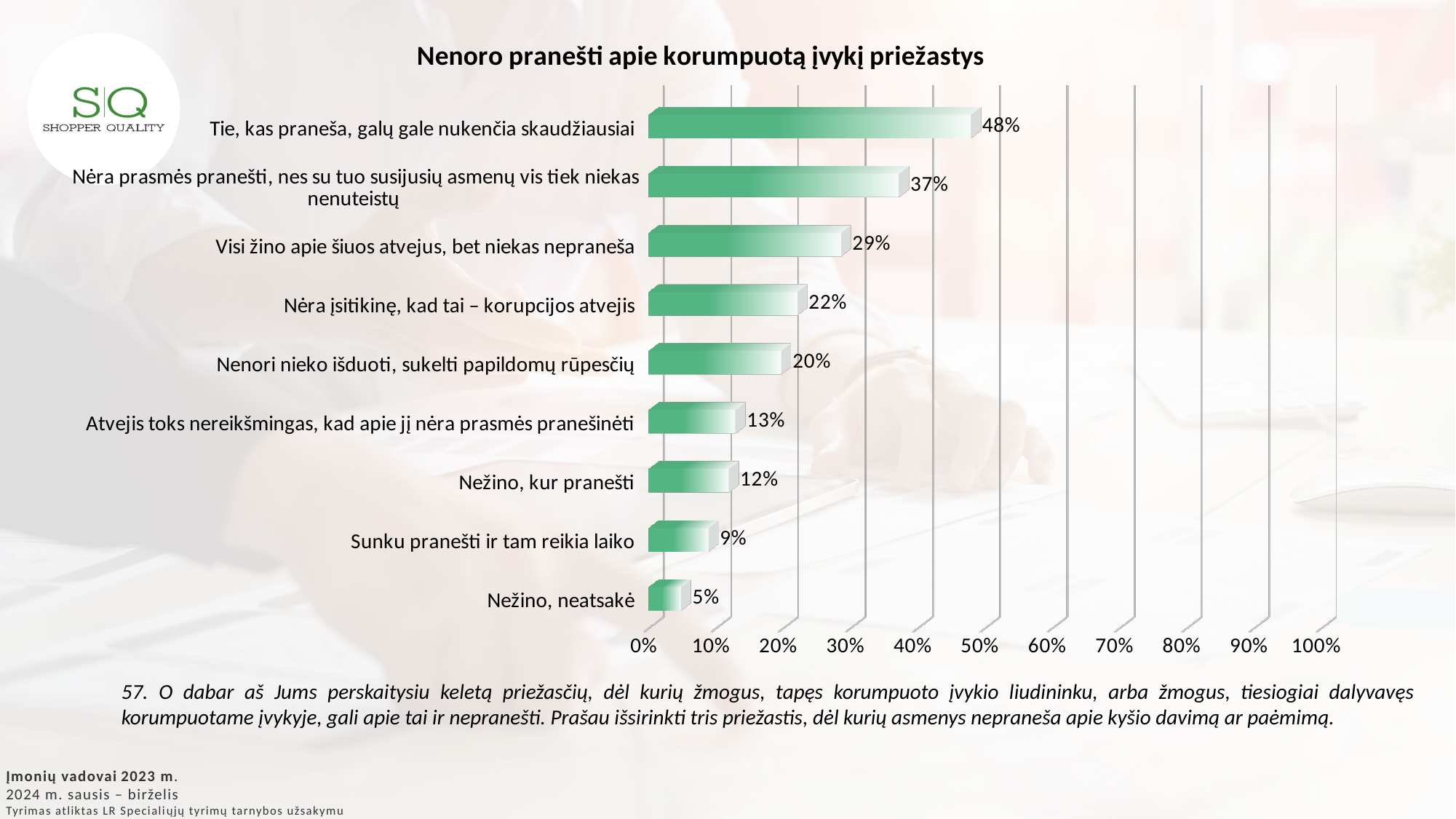
Which category has the highest value? Tie, kas praneša, galų gale nukenčia skaudžiausiai Which category has the lowest value? Nežino, neatsakė What is the maximum value shown on the horizontal axis? 100% What is the value for "Nežino, kur pranešti"? 12% Which is larger: the value for "Nenori nieko išduoti, sukelti papildomų rūpesčių" or the value for "Sunku pranešti ir tam reikia laiko"? Nenori nieko išduoti, sukelti papildomų rūpesčių What is the value for "Tie, kas praneša, galų gale nukenčia skaudžiausiai"? 48% Is the value for "Nėra prasmės pranešti, nes su tuo susijusių asmenų vis tiek niekas nenuteistų" greater or less than 30%? greater What kind of chart is shown on the slide? bar chart What is the value for "Nėra įsitikinę, kad tai – korupcijos atvejis"? 22% What is the difference between the values for "Tie, kas praneša, galų gale nukenčia skaudžiausiai" and "Visi žino apie šiuos atvejus, bet niekas nepraneša"? 19% What is the title of the chart? Nenoro pranešti apie korumpuotą įvykį priežastys How many categories are shown in the chart? 9